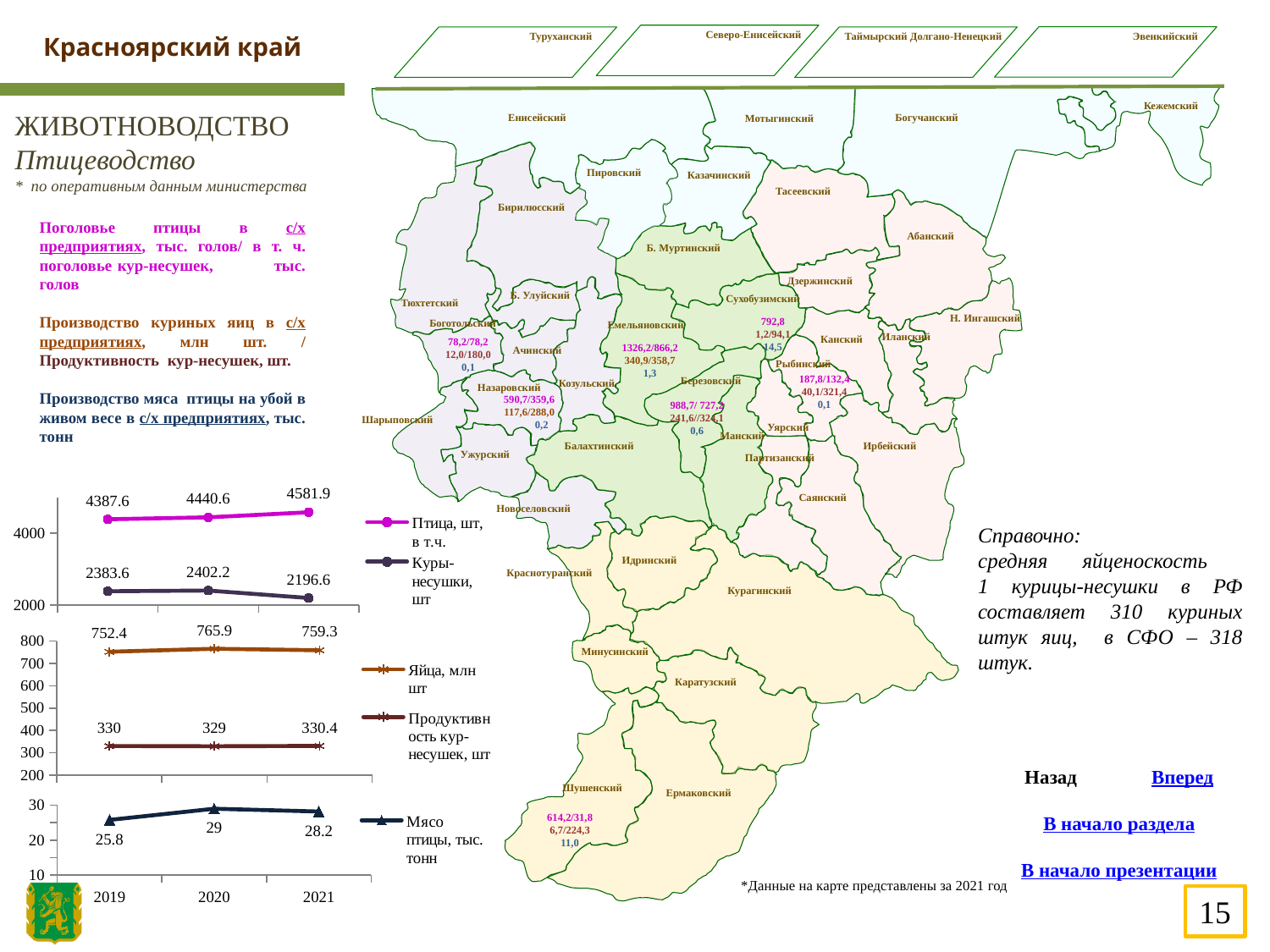
On the top line chart on the left, in which year is 'Куры-несушки, шт' lowest? 2021 How many years are shown on the x axis of the line charts on the left? 3 On the bottom line chart on the left, which is larger: the 'Мясо птицы, тыс. тонн' value for 2020 or for 2021? 2020 On the top line chart on the left, does 'Птица, шт, в т.ч.' rise or fall from 2019 to 2021? rise On the middle line chart on the left, in which year is 'Яйца, млн шт' highest? 2020 On the top line chart on the left, what is the value for 'Птица, шт, в т.ч.' in 2021? 4581.9 On the top line chart on the left, what is the value for 'Куры-несушки, шт' in 2020? 2402.2 On the middle line chart on the left, how many series does the legend list? 2 On the middle line chart on the left, what is the value for 'Яйца, млн шт' in 2020? 765.9 On the top line chart on the left, what is the difference between the 'Птица, шт, в т.ч.' values for 2021 and 2019? 194.3 On the middle line chart on the left, what is the value for 'Продуктивность кур-несушек, шт' in 2021? 330.4 On the bottom line chart on the left, what is the value for 'Мясо птицы, тыс. тонн' in 2019? 25.8